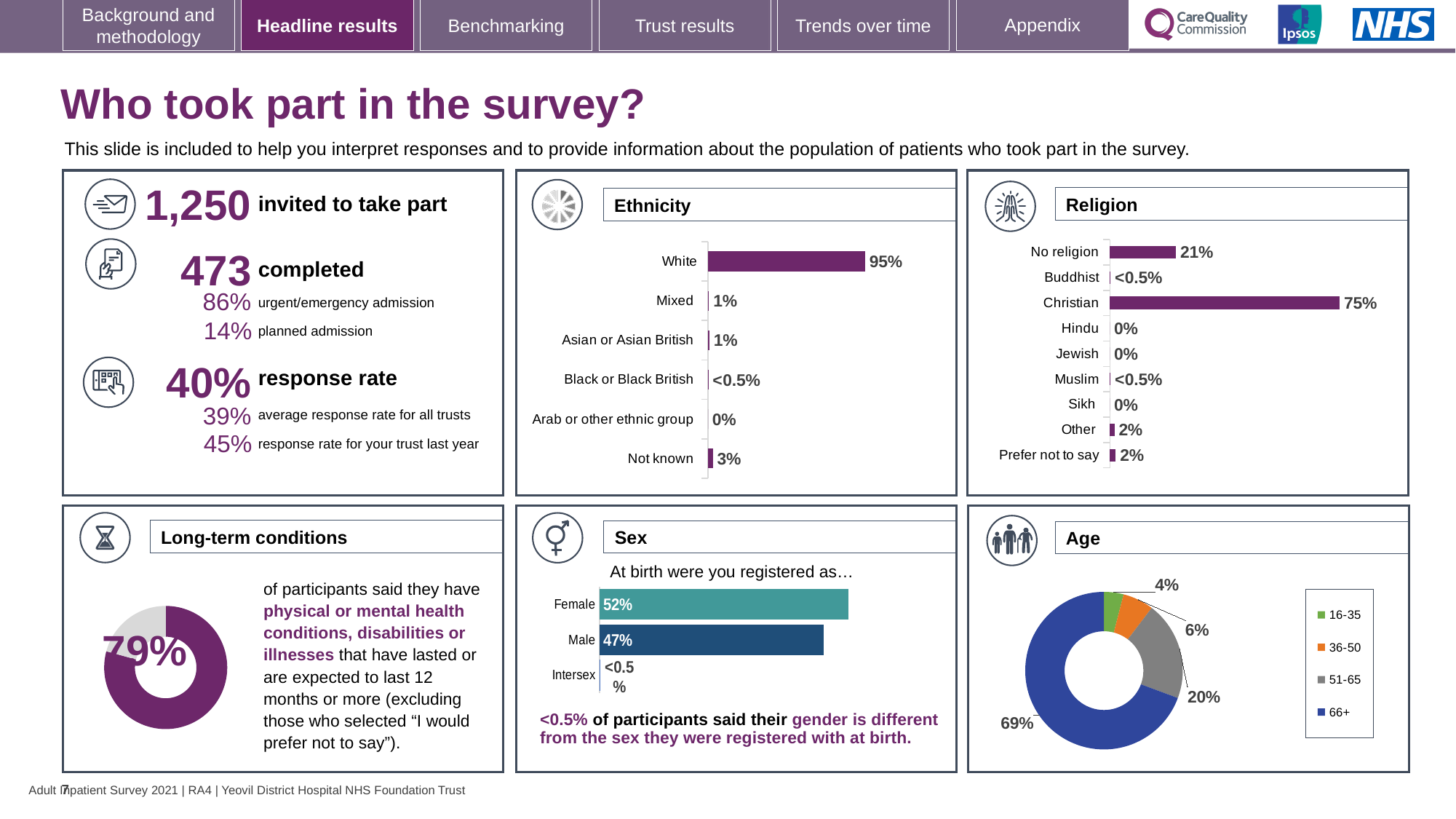
In the Religion chart, what percentage of participants were Christian? 75% In the Ethnicity chart, what is the value for Not known? 3% In the Sex chart, what is the value for Male? 47% How many entries does the legend of the Age chart list? 4 How many categories are shown in the Ethnicity chart? 6 In the Sex chart, which is larger, Female or Male? Female In the Religion chart, what is the difference between the Christian and No religion values? 54% In the Ethnicity chart, which category has the highest value? White In the Ethnicity chart, what percentage of participants were White? 95% What kind of chart is the Age chart? Doughnut chart How many categories are shown in the Religion chart? 9 In the Age chart, what share of participants were aged 66+? 69%